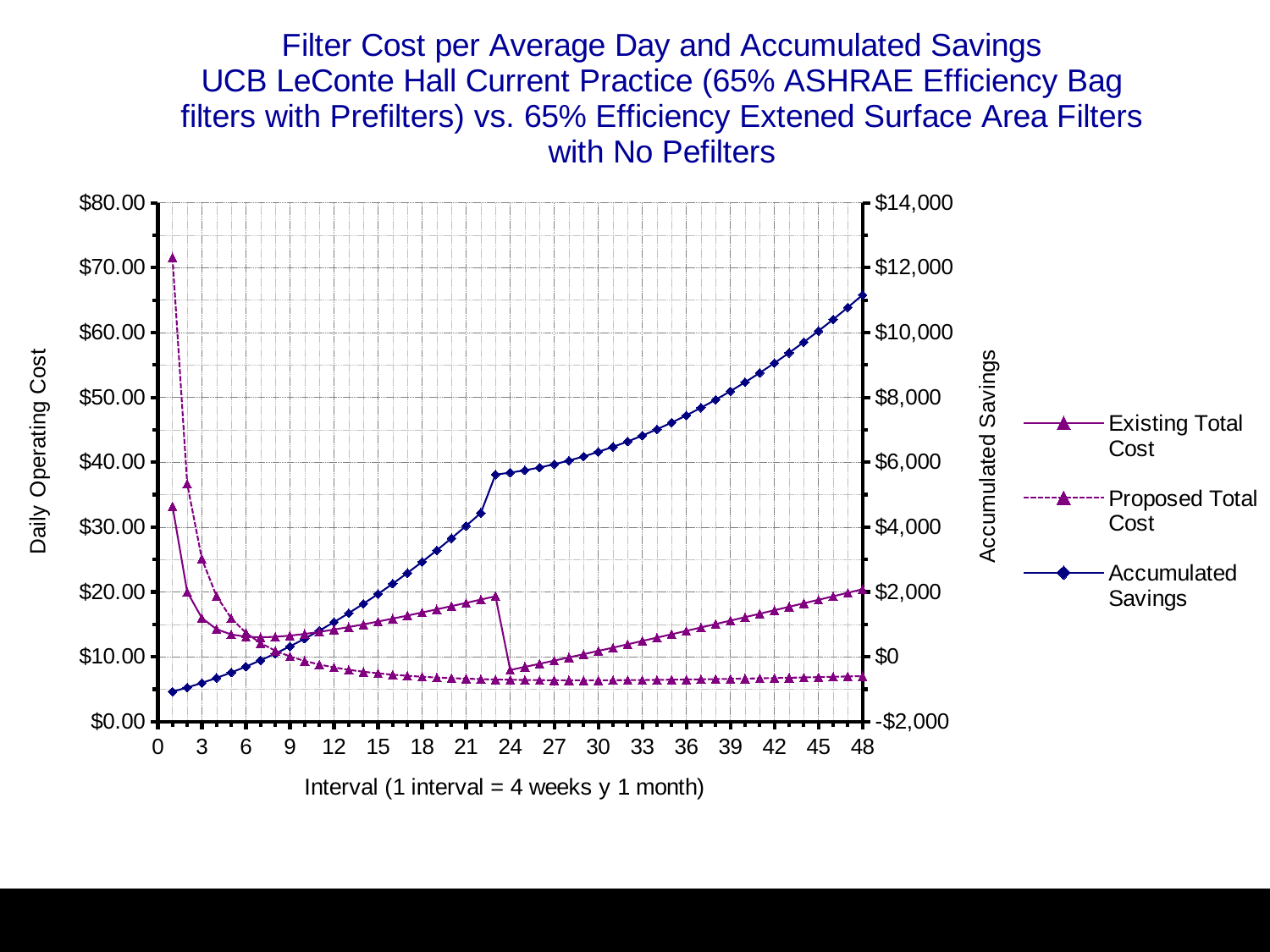
At interval 48, which is larger: Existing Total Cost or Proposed Total Cost? Existing Total Cost Is the Accumulated Savings value at interval 48 greater or less than $10,000? greater Is the Proposed Total Cost value at interval 1 greater or less than $60.00? greater What is the title of the x axis? Interval (1 interval = 4 weeks y 1 month) Is the Accumulated Savings value at interval 24 greater or less than $4,000? greater At interval 1, which is larger: Existing Total Cost or Proposed Total Cost? Proposed Total Cost Which series is plotted with a dashed line? Proposed Total Cost How many series does the legend list? 3 What kind of chart is shown on the slide? line chart Does the Accumulated Savings series rise or fall as the interval increases? rise